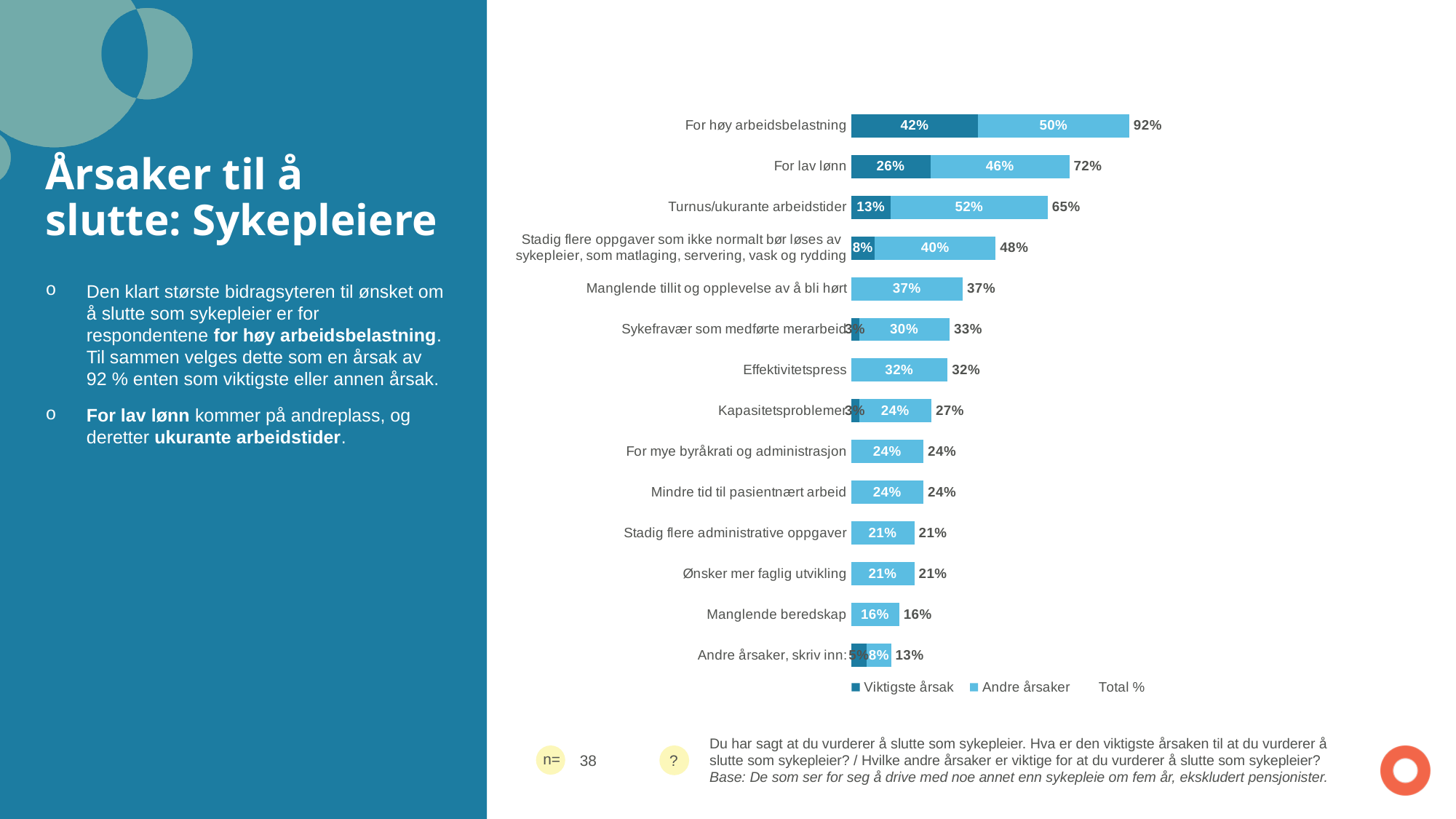
What kind of chart is shown on the slide? Stacked bar chart What is the difference between the total for 'For høy arbeidsbelastning' and the total for 'For lav lønn'? 20% What is the total of the stacked bar for 'Sykefravær som medførte merarbeid'? 33% How many entries does the legend list? 3 What is the 'Andre årsaker' value for 'For lav lønn'? 46% What is the 'Viktigste årsak' value for 'Andre årsaker, skriv inn:'? 5% What is the total percentage shown for 'Turnus/ukurante arbeidstider'? 65% Which category has the lowest total percentage? Andre årsaker, skriv inn: What is the 'Viktigste årsak' value for 'For høy arbeidsbelastning'? 42% Which has a larger 'Andre årsaker' value: 'Turnus/ukurante arbeidstider' or 'For høy arbeidsbelastning'? Turnus/ukurante arbeidstider How many categories are shown in the chart? 14 Which category has the highest total percentage? For høy arbeidsbelastning